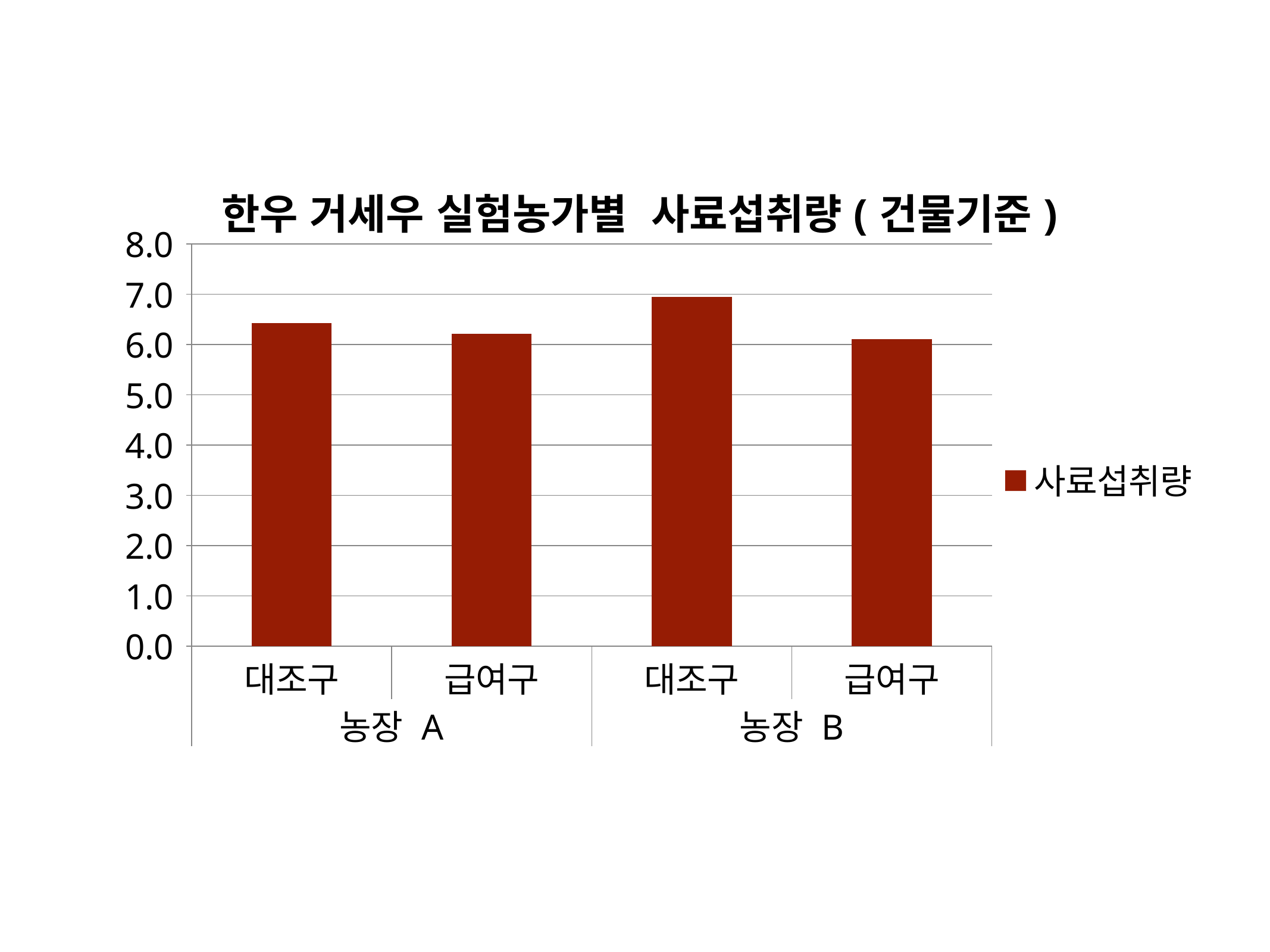
Is the value for 대조구 in 농장 B greater or less than 6.0? greater Is the value for 급여구 in 농장 A greater or less than 7.0? less Is the value for 대조구 in 농장 A greater or less than 6.0? greater How many series does the legend list? 1 What is the name of the series shown in the legend? 사료섭취량 How many bars are plotted in the chart? 4 Which is larger, the value for 대조구 in 농장 A or the value for 대조구 in 농장 B? 대조구 in 농장 B What is the title of the chart? 한우 거세우 실험농가별 사료섭취량 ( 건물기준 ) What kind of chart is shown on the slide? bar chart Which is larger, the value for 대조구 in 농장 B or the value for 급여구 in 농장 B? 대조구 in 농장 B Which bar has the highest value? 농장 B 대조구